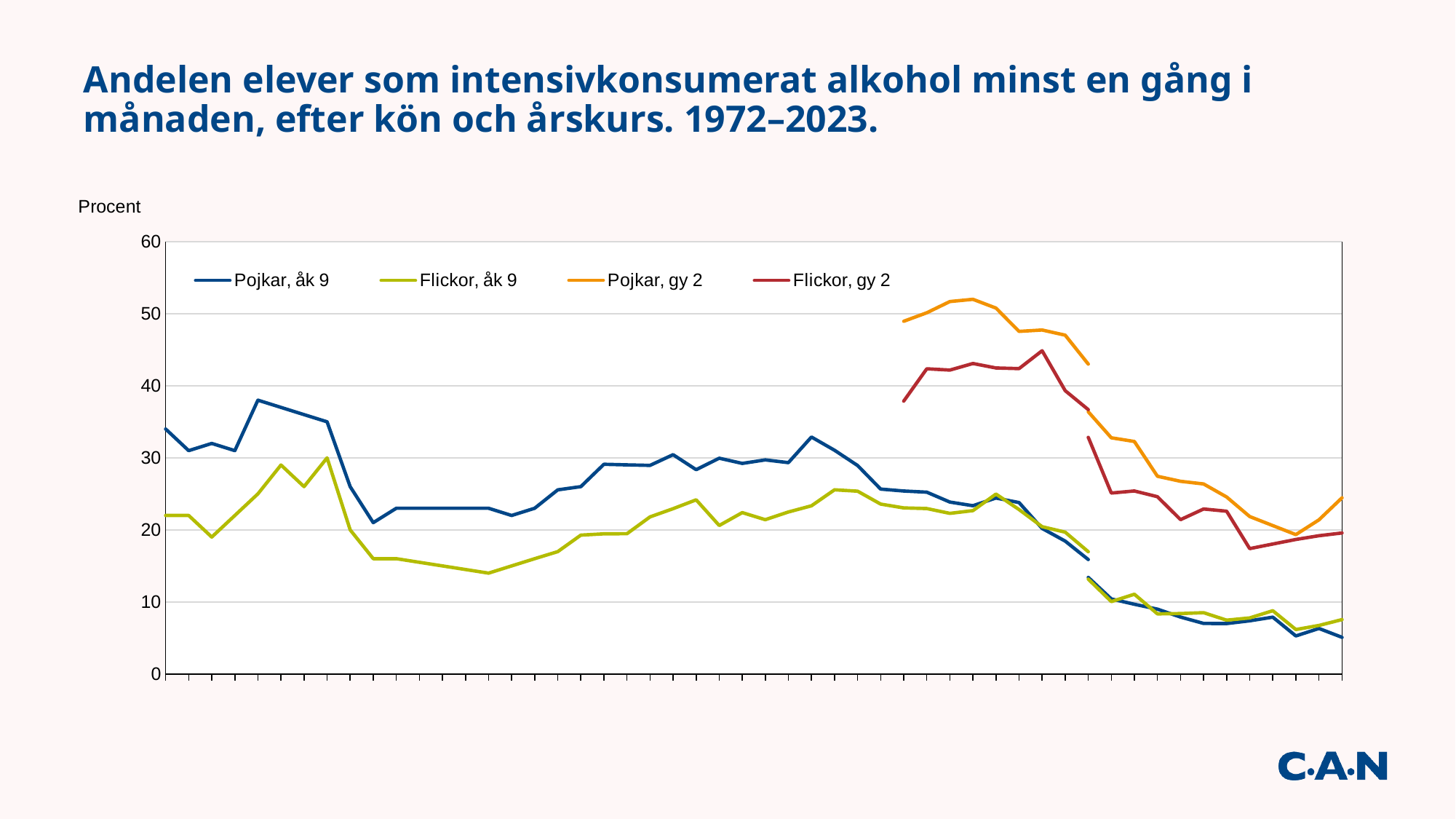
At the right end of the chart, which series is higher: Pojkar, gy 2 or Flickor, gy 2? Pojkar, gy 2 Which series reaches the highest value anywhere on the chart? Pojkar, gy 2 What kind of chart is shown on the slide? Line chart How many series does the legend list? 4 What are the four series named in the legend? Pojkar, åk 9; Flickor, åk 9; Pojkar, gy 2; Flickor, gy 2 Is the first plotted value of the Pojkar, åk 9 series greater or less than 30? greater Is the first plotted value of the Flickor, gy 2 series greater or less than 40? less Is the peak value of the Pojkar, gy 2 series greater or less than 50? greater Does the Pojkar, åk 9 series overall rise or fall from the left of the chart to the right? fall What label is shown on the vertical axis of the chart? Procent At the right end of the chart, which series is lower: Pojkar, åk 9 or Flickor, åk 9? Pojkar, åk 9